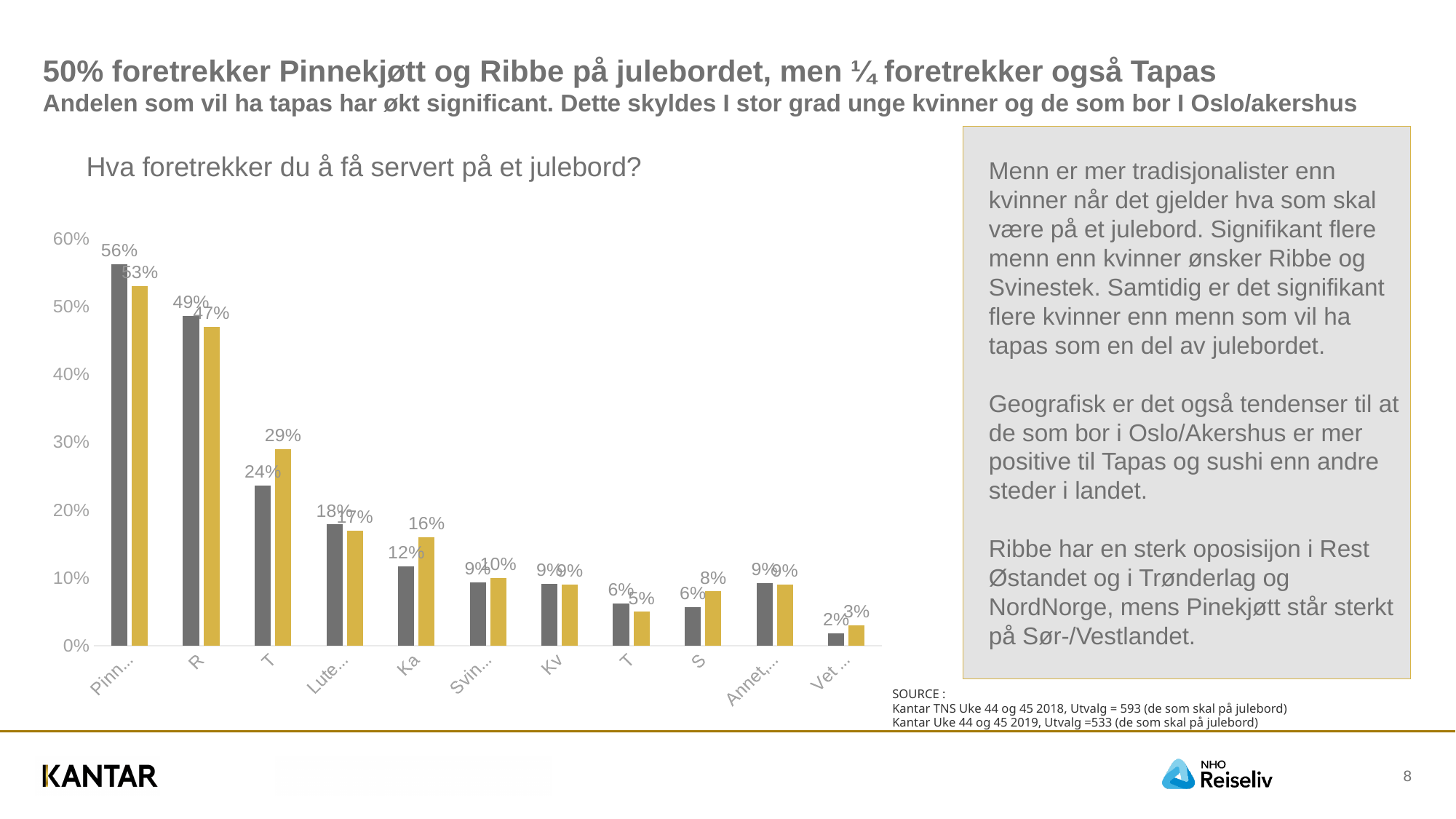
For the category "Lute...", which bar is larger, the grey bar or the gold bar? the grey bar What is the value of the gold bar for the category "Vet ..."? 3% What is the value of the grey bar for the category "Pinn..."? 56% How many categories are shown on the x axis of the chart? 11 Which category has the highest grey bar in the chart? Pinn... What is the value of the gold bar for the category "Pinn..."? 53% What is the title of the chart on the slide? Hva foretrekker du å få servert på et julebord? What kind of chart is shown on the slide? bar chart What is the value of the gold bar for the category "Lute..."? 17% What is the difference between the grey bar and the gold bar for the category "Pinn..."? 3% What is the value of the grey bar for the category "R"? 49% Which category has the lowest grey bar in the chart? Vet ...